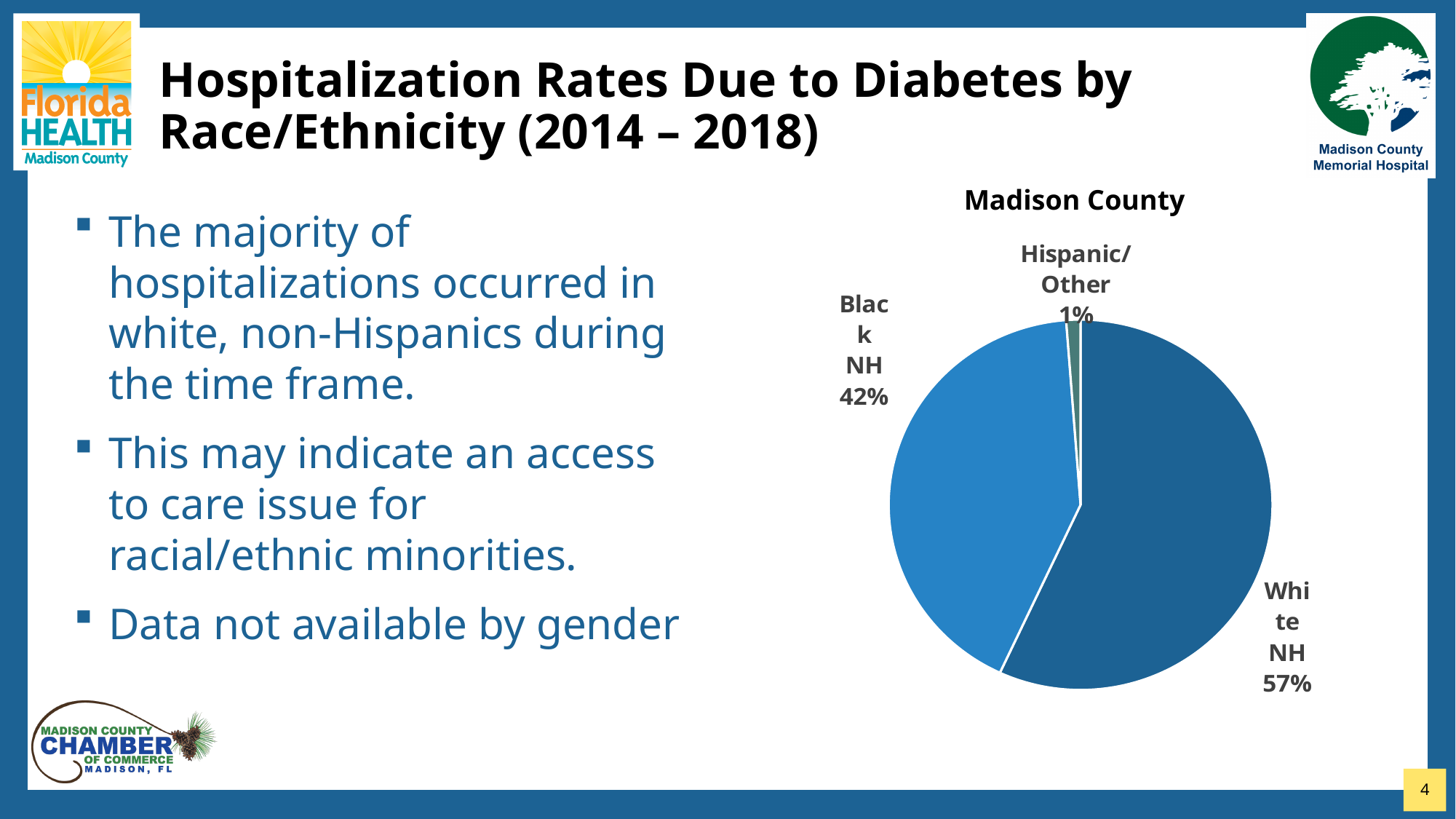
Which is larger, the share for Black NH or the share for Hispanic/Other? Black NH What share of the pie is Hispanic/Other? 1% What share of the pie is White NH? 57% What share of the pie is Black NH? 42% Which category has the largest slice of the pie? White NH What kind of chart is shown on the slide? Pie chart What is the difference in percentage points between White NH and Black NH? 15 Which category has the smallest slice of the pie? Hispanic/Other How many categories are shown in the pie chart? 3 What is the chart's title? Madison County What is the difference in percentage points between Black NH and Hispanic/Other? 41 Which is larger, the share for White NH or the share for Black NH? White NH